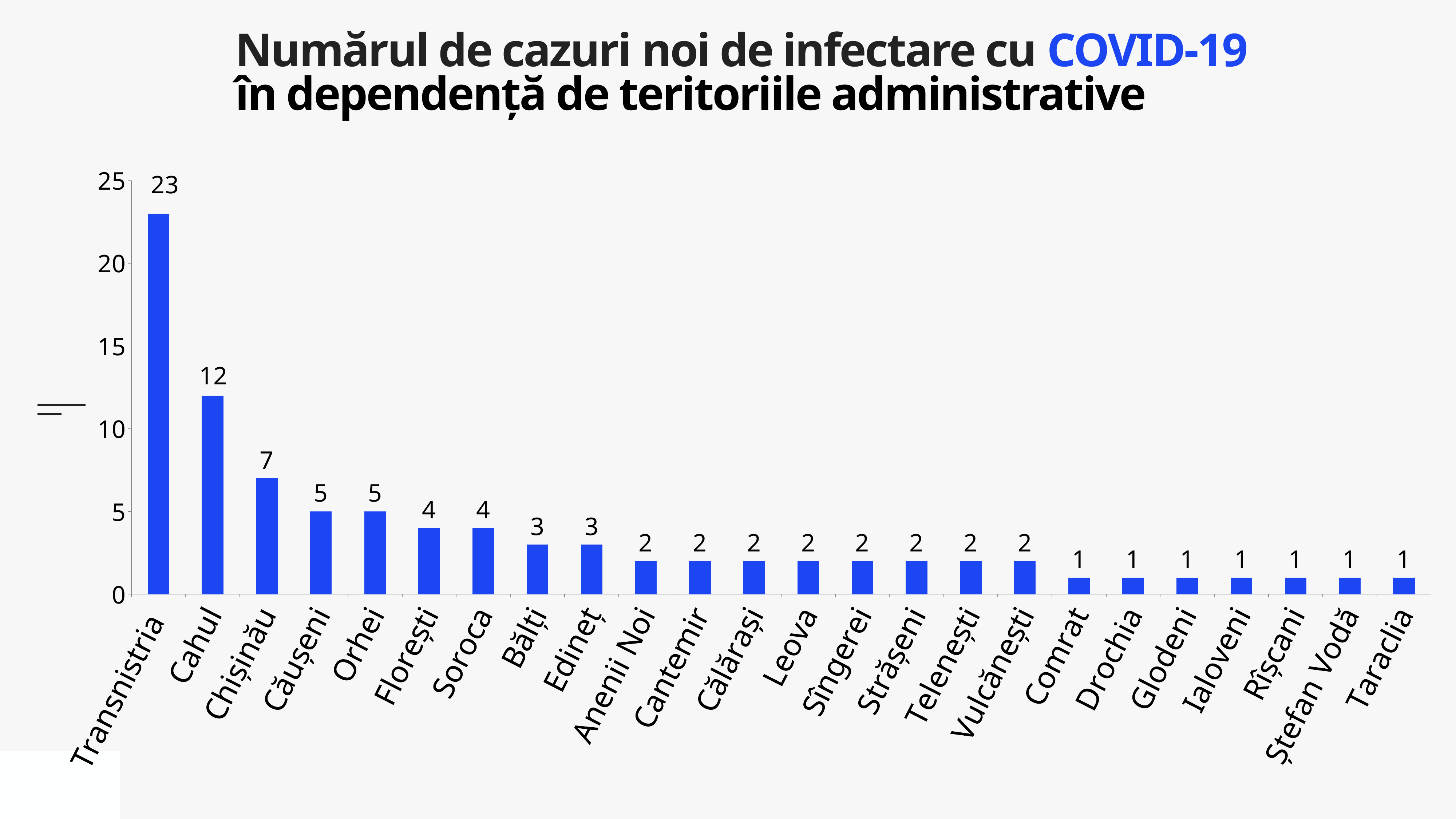
Is the value for Transnistria greater or less than 20? greater What is the difference between the values for Chișinău and Orhei? 2 What is the value for Transnistria? 23 Do the values rise or fall from left to right along the x axis? Fall What is the value for Soroca? 4 How many territories are shown on the chart? 24 Which territory has the highest number of new cases? Transnistria Which has a larger value, Cahul or Chișinău? Cahul What is the value for Chișinău? 7 What is the difference between the values for Transnistria and Cahul? 11 What is the value for Cahul? 12 What kind of chart is shown on the slide? Bar chart